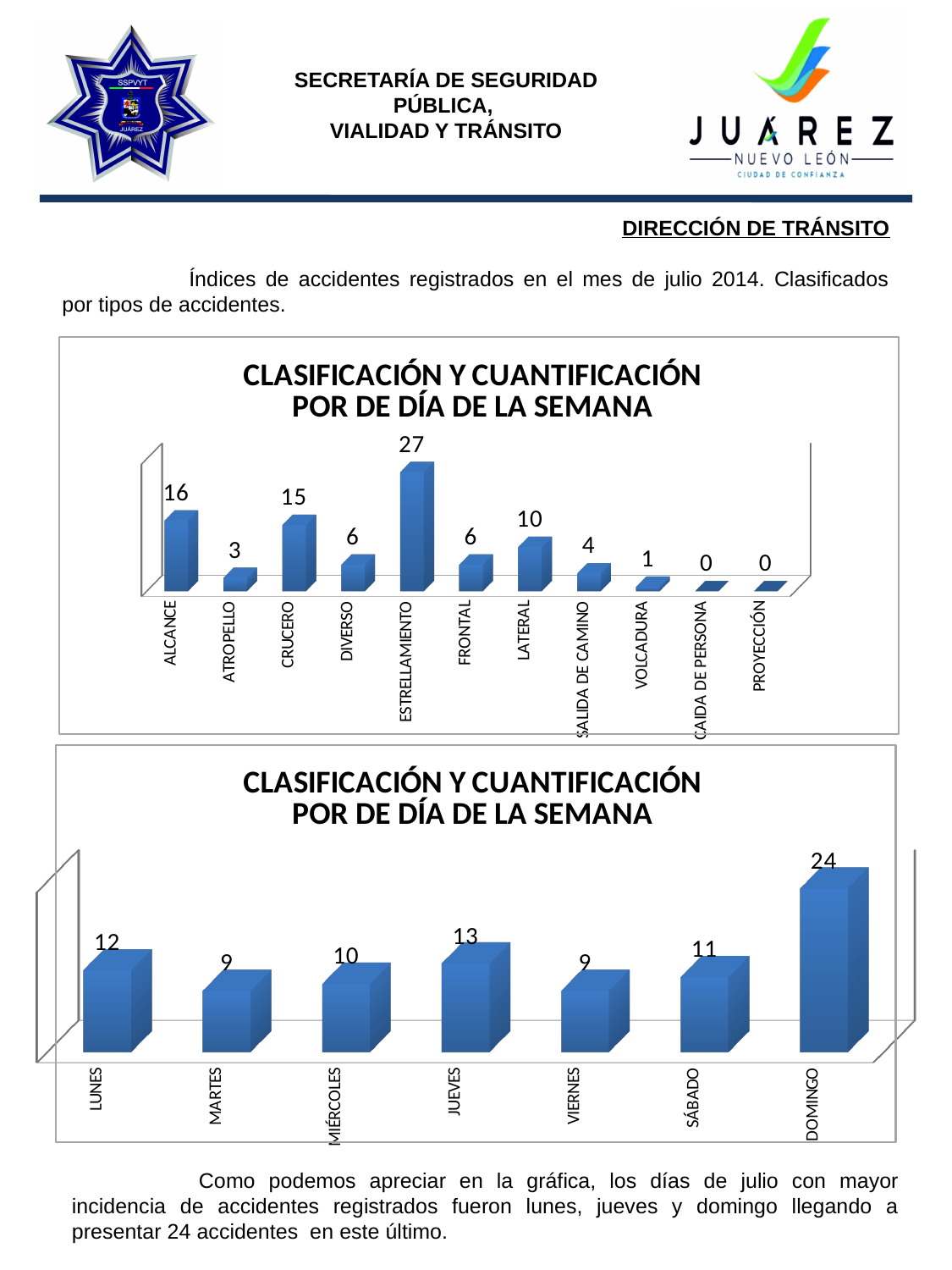
In the bottom chart, how many days are shown? 7 In the bottom chart, what is the difference between the values for DOMINGO and JUEVES? 11 In the top chart, which category has the highest value? ESTRELLAMIENTO In the bottom chart, which is larger, the value for LUNES or the value for MIÉRCOLES? LUNES What kind of chart is the bottom chart? Bar chart In the top chart, what is the value for ALCANCE? 16 In the bottom chart, what is the value for DOMINGO? 24 In the top chart, what is the value for ESTRELLAMIENTO? 27 In the top chart, what is the difference between the values for CRUCERO and ATROPELLO? 12 In the top chart, how many categories are shown? 11 In the top chart, which is larger, the value for LATERAL or the value for SALIDA DE CAMINO? LATERAL In the bottom chart, which day has the highest value? DOMINGO